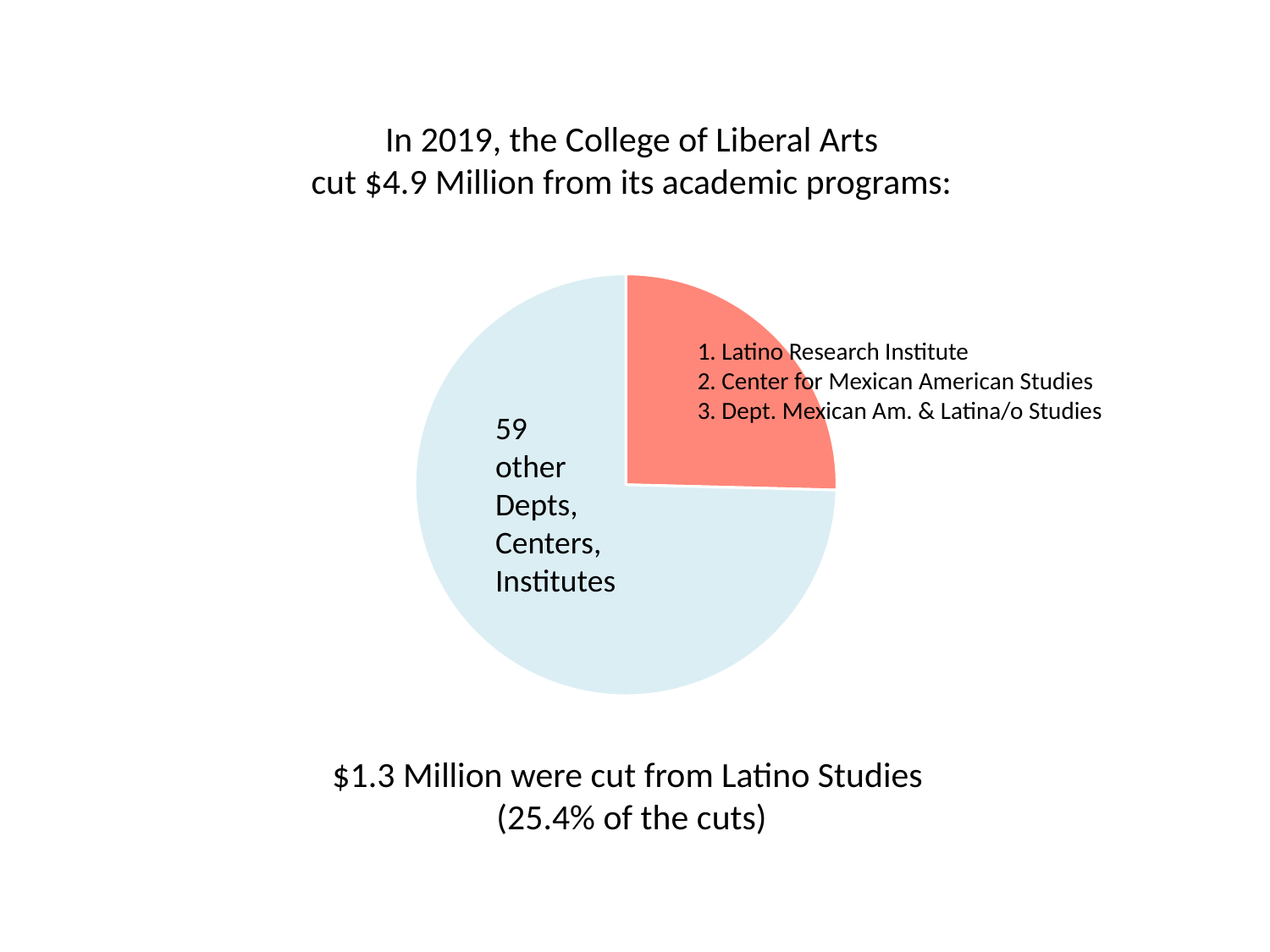
What kind of chart is shown on the slide? pie chart What colour is the slice representing the Latino Studies cuts? red What share of the cuts does the Latino Studies slice represent? 25.4% Which slice of the pie is the smallest? Latino Studies How many Latino Studies units are listed next to the red slice? 3 How many slices does the pie chart have? 2 How many other Depts, Centers, Institutes make up the light blue slice? 59 How much money was cut from Latino Studies according to the slide? $1.3 Million What total amount did the College of Liberal Arts cut from its academic programs in 2019? $4.9 Million Which unit is listed first next to the red slice? Latino Research Institute Which slice of the pie is larger: Latino Studies or the 59 other Depts, Centers, Institutes? 59 other Depts, Centers, Institutes